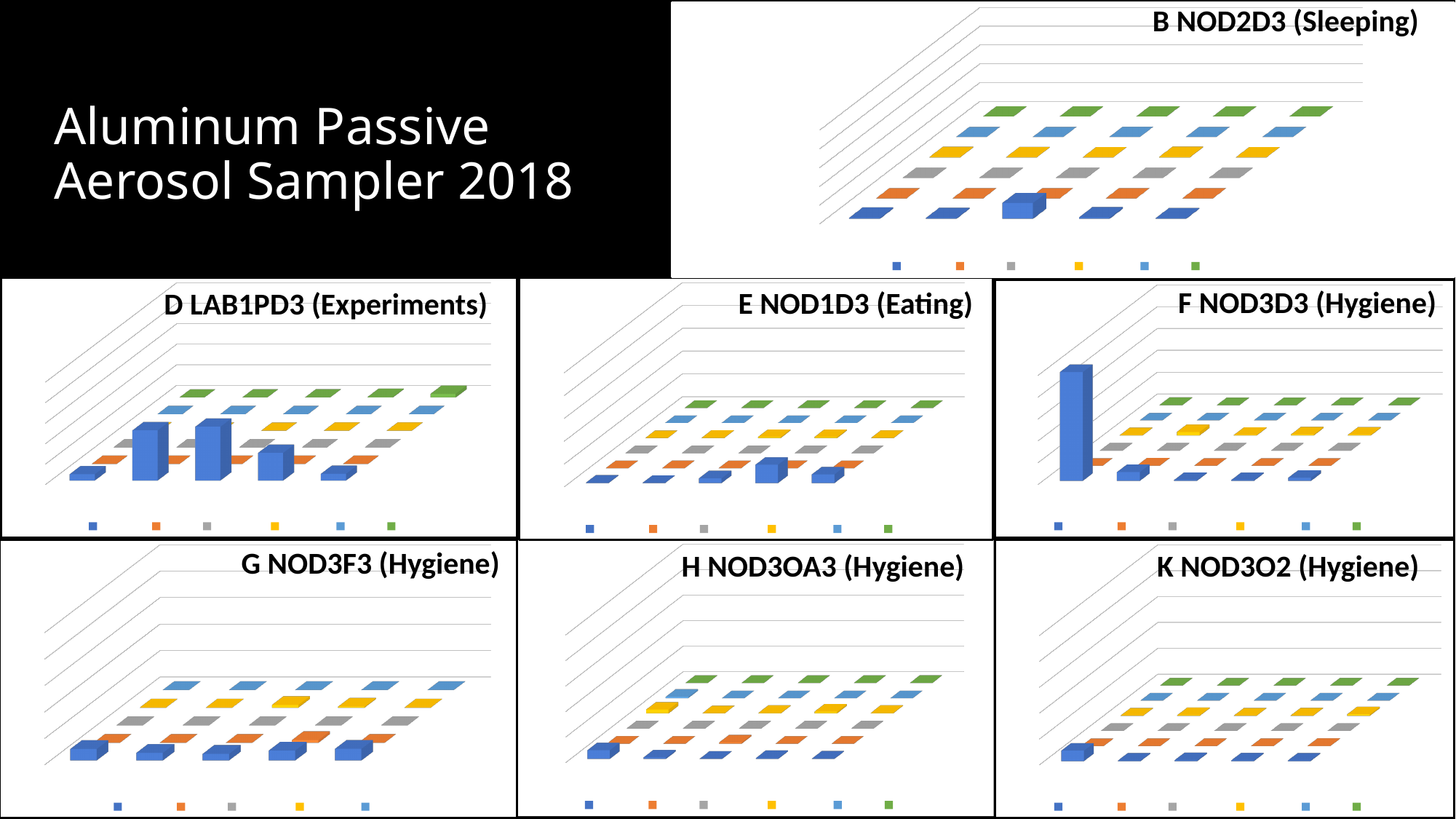
Which chart on the slide contains the tallest bar? F NOD3D3 (Hygiene) How many categories are plotted along the front row of F NOD3D3 (Hygiene)? 5 How many charts are shown on the slide? 7 How many series does the legend of K NOD3O2 (Hygiene) list? 6 What kind of chart is B NOD2D3 (Sleeping)? bar chart How many categories are plotted along the front row of E NOD1D3 (Eating)? 5 What is the title of the chart in the top right of the slide? B NOD2D3 (Sleeping) How many series does the legend of G NOD3F3 (Hygiene) list? 5 How many series does the legend of D LAB1PD3 (Experiments) list? 6